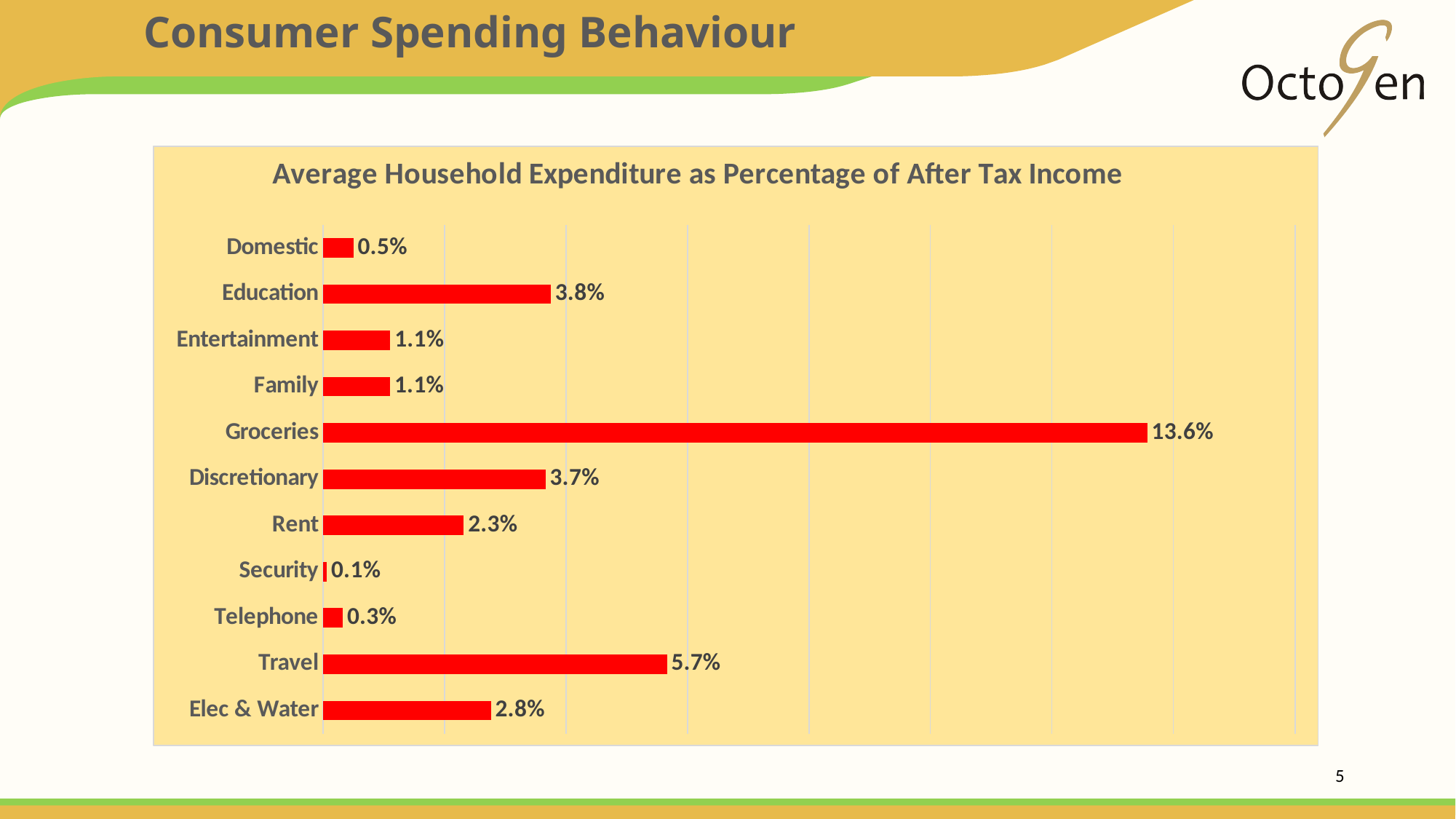
What is the difference between the values for Groceries and Travel? 7.9% What is the value for Travel? 5.7% What is the value for Elec & Water? 2.8% Which is larger, the value for Rent or the value for Elec & Water? Elec & Water What is the title of the chart? Average Household Expenditure as Percentage of After Tax Income What is the value for Rent? 2.3% What is the difference between the values for Education and Discretionary? 0.1% What kind of chart is shown on the slide? Bar chart What is the value for Groceries? 13.6% How many categories are shown in the chart? 11 Which category has the lowest value? Security Which category has the highest value? Groceries